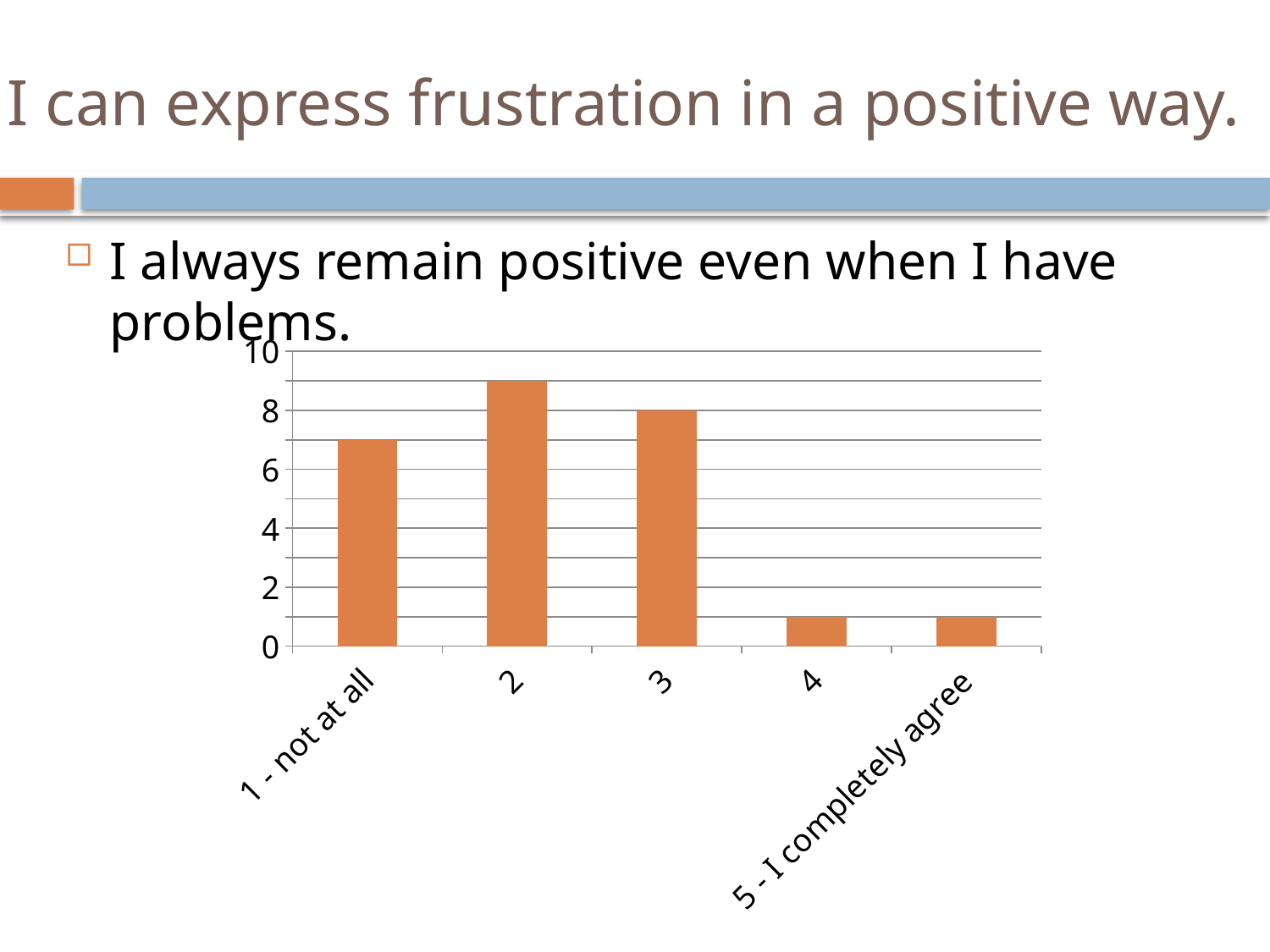
Which is larger, the value for "1 - not at all" or the value for category 3? 3 Is the value for "1 - not at all" greater or less than 8? less Is the value for "1 - not at all" greater or less than 6? greater Is the value for category 2 greater or less than 8? greater What kind of chart is shown on the slide? bar chart Which is larger, the value for category 2 or the value for category 3? 2 What is the value for category 3? 8 What colour are the bars in the chart? orange How many categories are shown on the x axis of the chart? 5 Which category has the highest value? 2